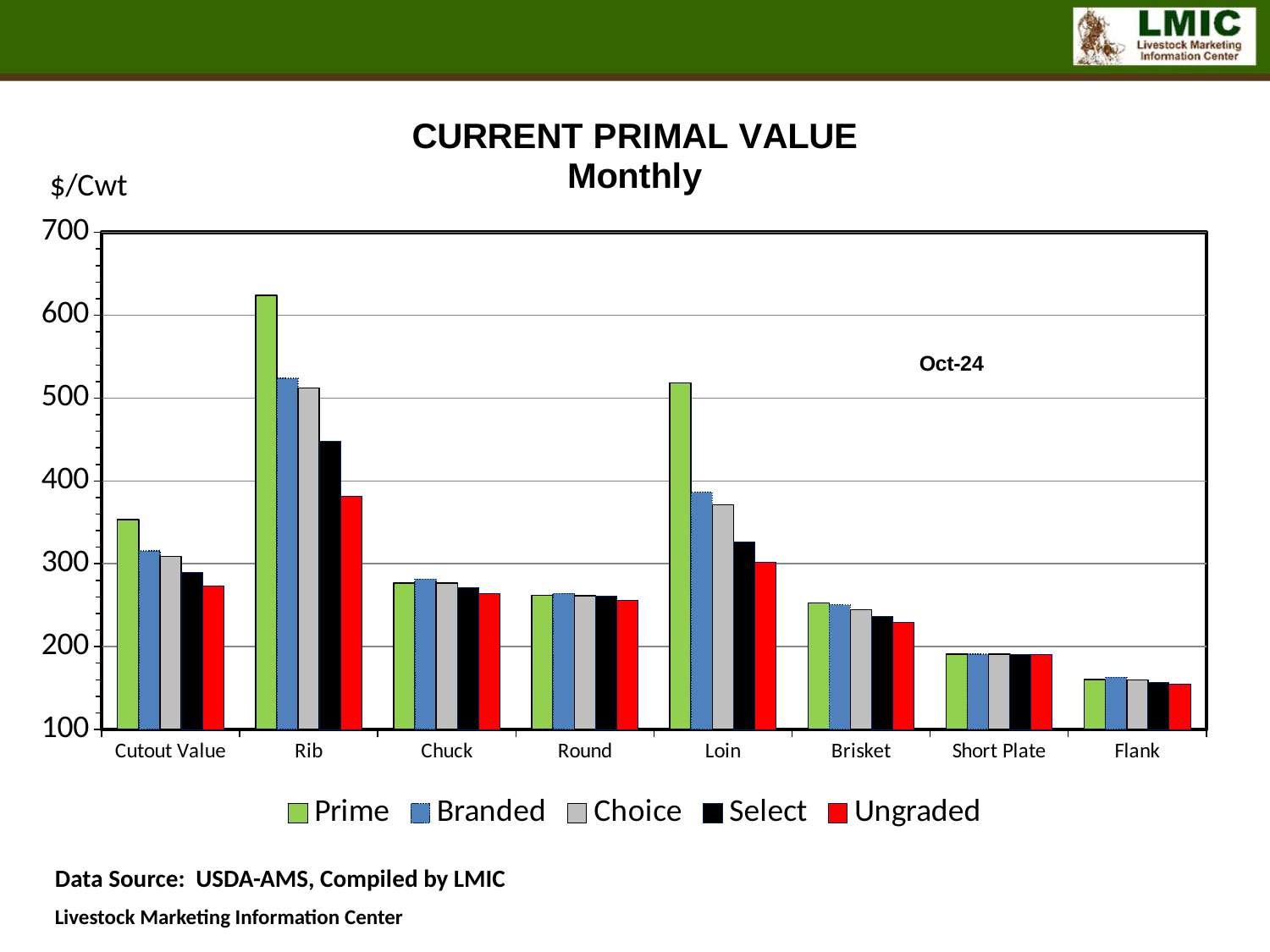
What kind of chart is shown on the slide? Bar chart How many primal categories are shown along the x axis? 8 Is the Ungraded value for Rib greater or less than 400? less Which is larger, the Prime value for Rib or the Prime value for Loin? Rib Which category has the lowest Prime value? Flank Is the Prime value for Short Plate greater or less than 200? less What month label is shown inside the chart area? Oct-24 Is the Prime value for Rib greater or less than 600? greater Which category has the highest Prime value? Rib How many series does the legend list? 5 For Cutout Value, which is larger, the Prime value or the Ungraded value? Prime